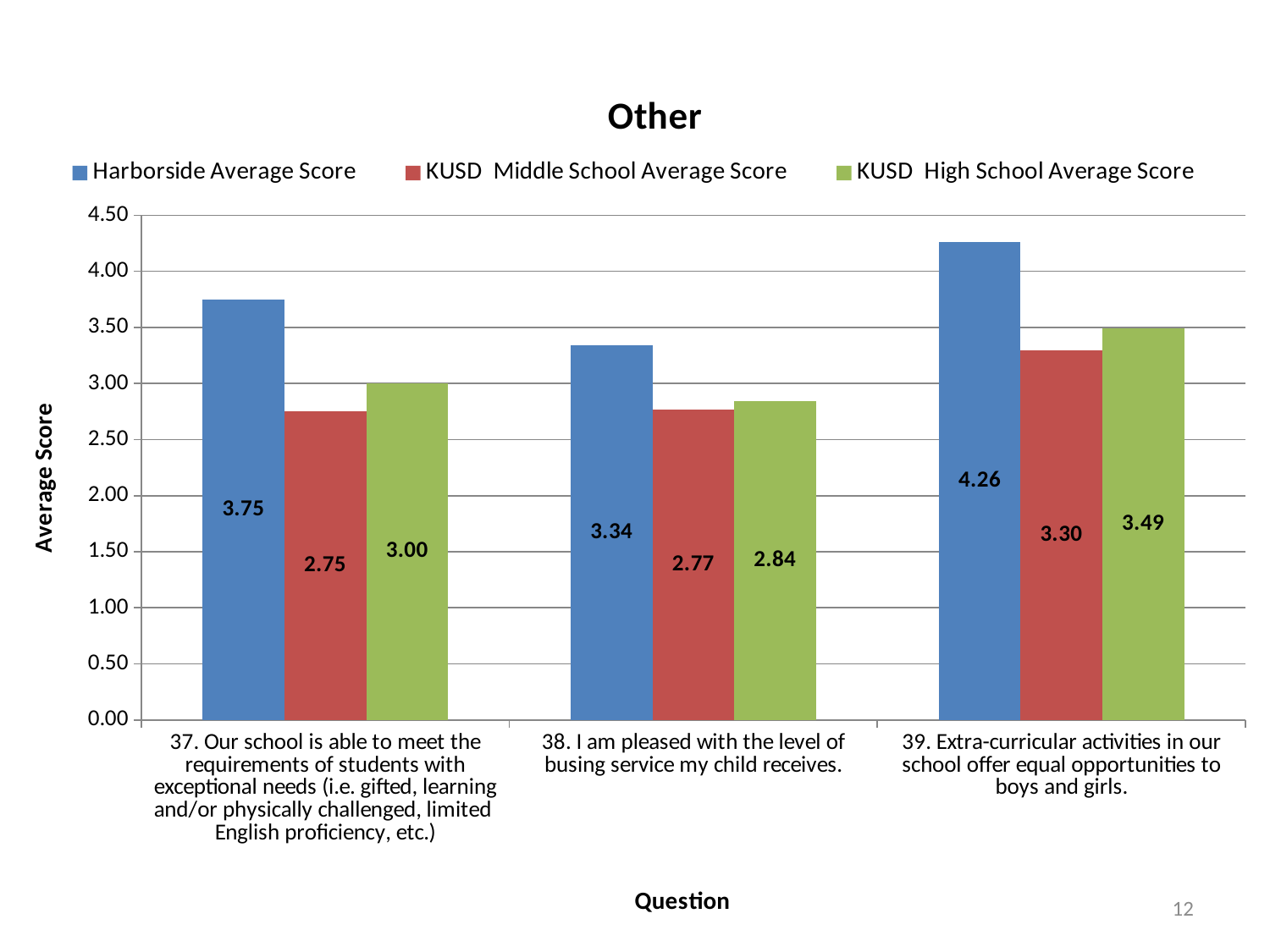
What is the difference between the Harborside Average Score and the KUSD High School Average Score for question 39? 0.77 How many series does the legend list? 3 Is the Harborside Average Score for question 39 greater or less than 4.00? greater What is the KUSD Middle School Average Score for question 39? 3.30 What is the difference between the Harborside Average Score and the KUSD Middle School Average Score for question 37? 1.00 What kind of chart is shown on the slide? Bar chart What is the Harborside Average Score for question 37? 3.75 For question 38, which is larger: the Harborside Average Score or the KUSD High School Average Score? Harborside Average Score What is the KUSD High School Average Score for question 38? 2.84 Which question has the highest Harborside Average Score? 39. Extra-curricular activities in our school offer equal opportunities to boys and girls. Which question has the lowest KUSD Middle School Average Score? 37. Our school is able to meet the requirements of students with exceptional needs (i.e. gifted, learning and/or physically challenged, limited English proficiency, etc.) How many questions are shown on the x axis of the chart? 3